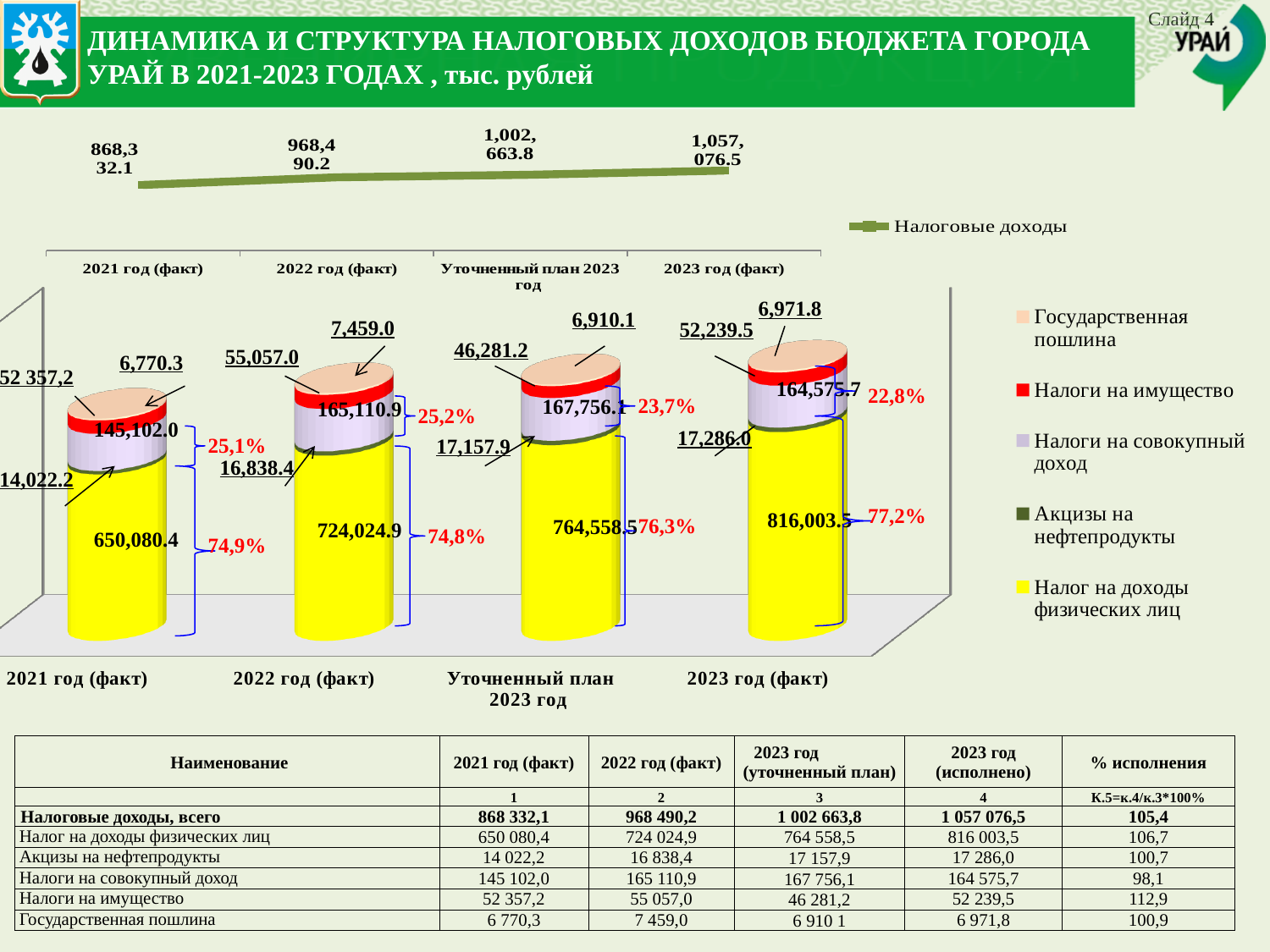
In the lower stacked bar chart, what is the value of Акцизы на нефтепродукты for 2021 год (факт)? 14,022.2 In the lower stacked bar chart, which period has the highest value for Налог на доходы физических лиц? 2023 год (факт) In the lower stacked bar chart, what is the total of the 2021 год (факт) bar? 868,332.1 In the lower stacked bar chart, how many series does the legend list? 5 In the lower stacked bar chart, what is the difference between Налог на доходы физических лиц for 2023 год (факт) and 2022 год (факт)? 91,978.6 In the lower stacked bar chart, how many bars (periods) are shown? 4 In the lower stacked bar chart, which is larger for Налоги на имущество: 2022 год (факт) or Уточненный план 2023 год? 2022 год (факт) In the upper line chart (Налоговые доходы), what is the value for 2022 год (факт)? 968,490.2 In the lower stacked bar chart, what is the value of Налог на доходы физических лиц for 2023 год (факт)? 816,003.5 In the upper line chart (Налоговые доходы), do the values rise or fall from 2021 год (факт) to 2023 год (факт)? Rise In the lower stacked bar chart, which period has the lowest value for Государственная пошлина? 2021 год (факт) What kind of chart is the lower chart with the coloured segments? Stacked bar chart